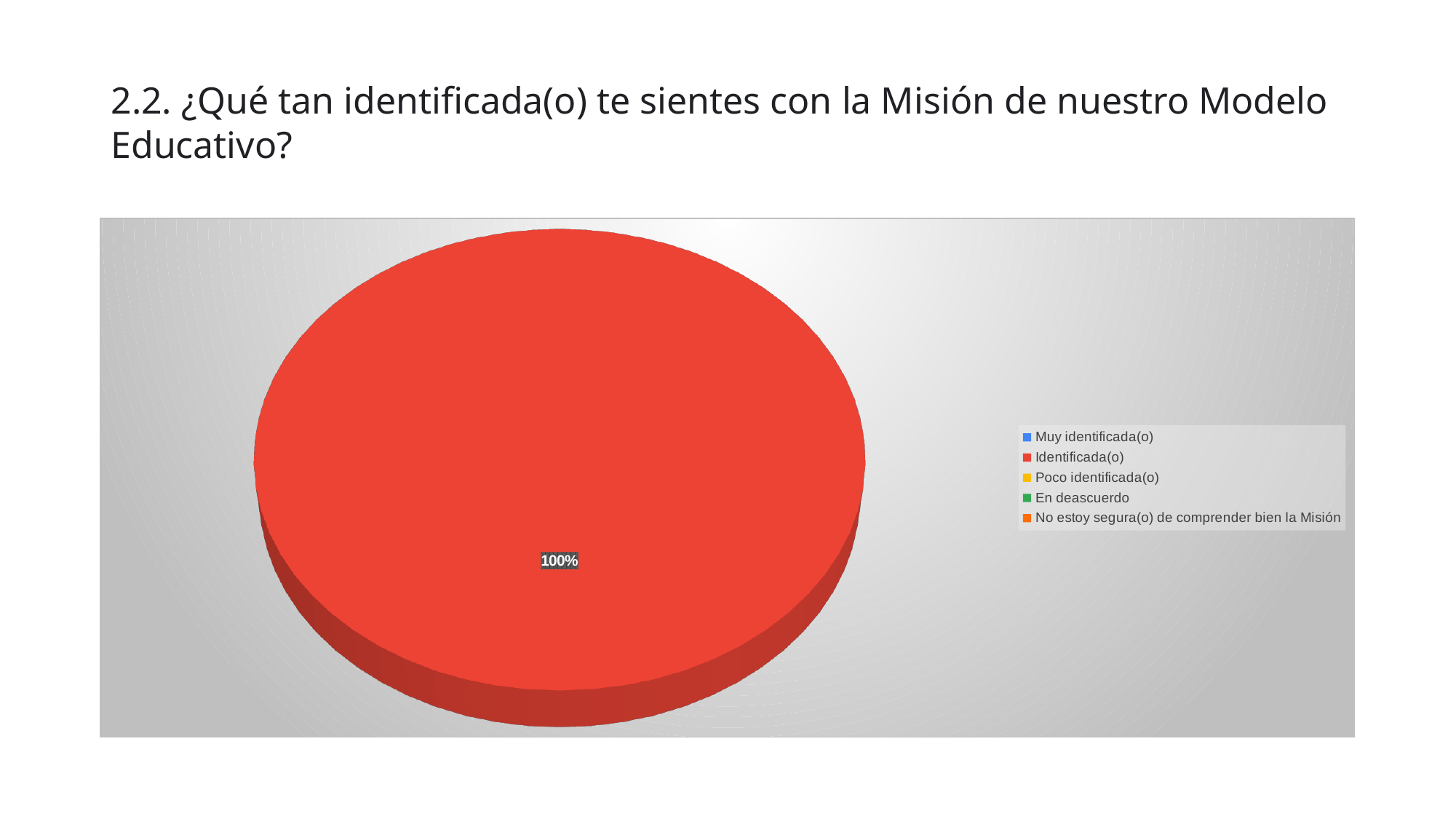
What kind of chart is shown on the slide? Pie chart Is the share for "Identificada(o)" greater or less than 50%? greater Which category accounts for the entire pie? Identificada(o) What is the data label printed on the pie slice? 100% What is the last entry listed in the legend? No estoy segura(o) de comprender bien la Misión Which is larger, the share for "Identificada(o)" or the share for "Muy identificada(o)"? Identificada(o) How many categories does the legend list? 5 What share of the pie does the "Identificada(o)" slice take? 100% Which colour represents "Identificada(o)" in the legend? Red